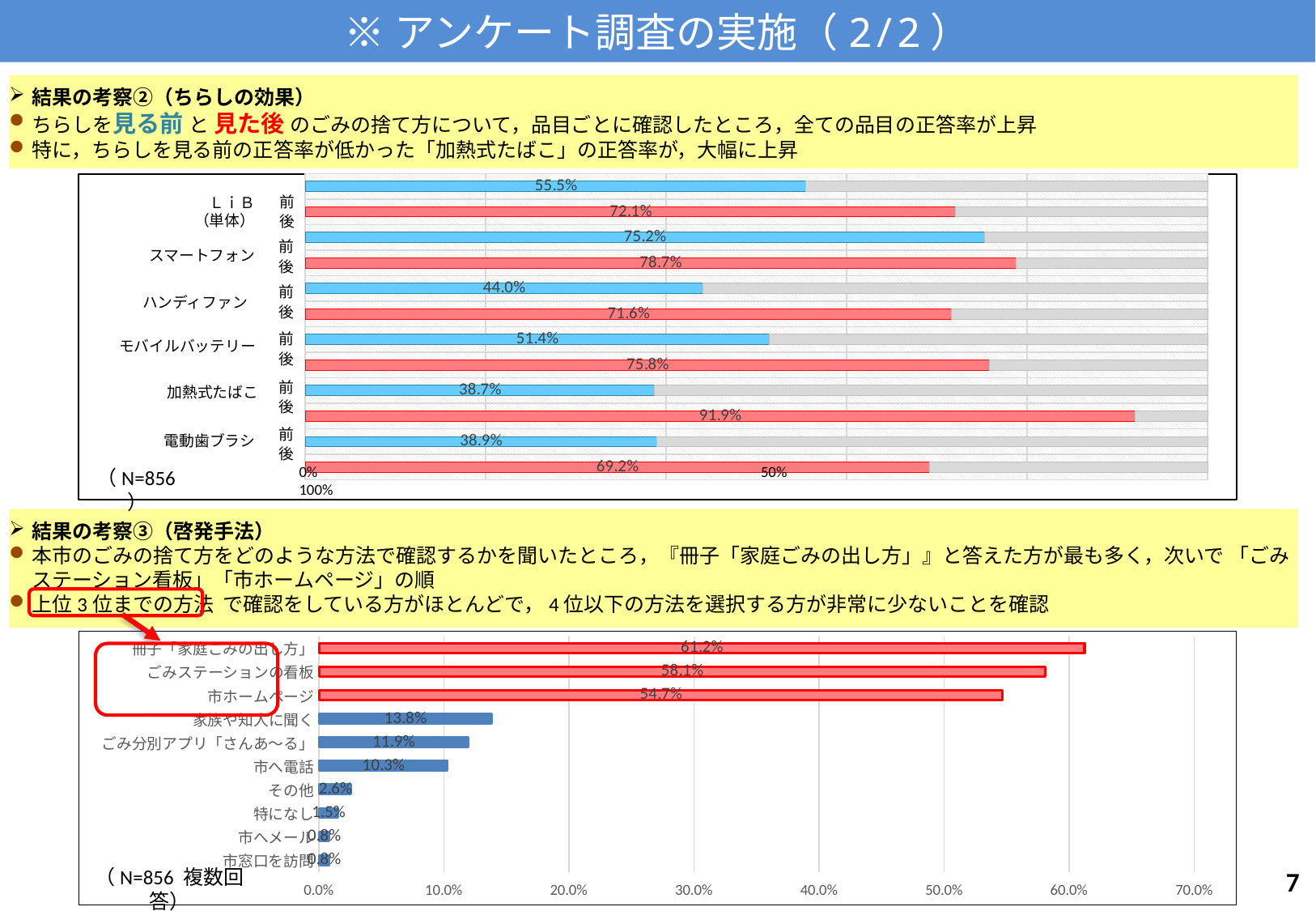
What type of chart is the bottom chart? Bar chart In the bottom chart, which is larger, 家族や知人に聞く or 市へ電話? 家族や知人に聞く In the top chart, how many items are compared? 6 In the bottom chart, what is the value for ごみステーションの看板? 58.1% In the bottom chart, what is the difference between 冊子「家庭ごみの出し方」 and 市ホームページ? 6.5% In the top chart, what is the difference between the 後 and 前 values for モバイルバッテリー? 24.4% In the bottom chart, which method has the highest value? 冊子「家庭ごみの出し方」 In the top chart, what is the 後 (after) value for ハンディファン? 71.6% In the top chart, which item has the highest 後 (after) value? 加熱式たばこ In the top chart, which item has the lowest 前 (before) value? 加熱式たばこ In the top chart, what is the 前 (before) value for 加熱式たばこ? 38.7% In the top chart, what is the 後 (after) value for 加熱式たばこ? 91.9%